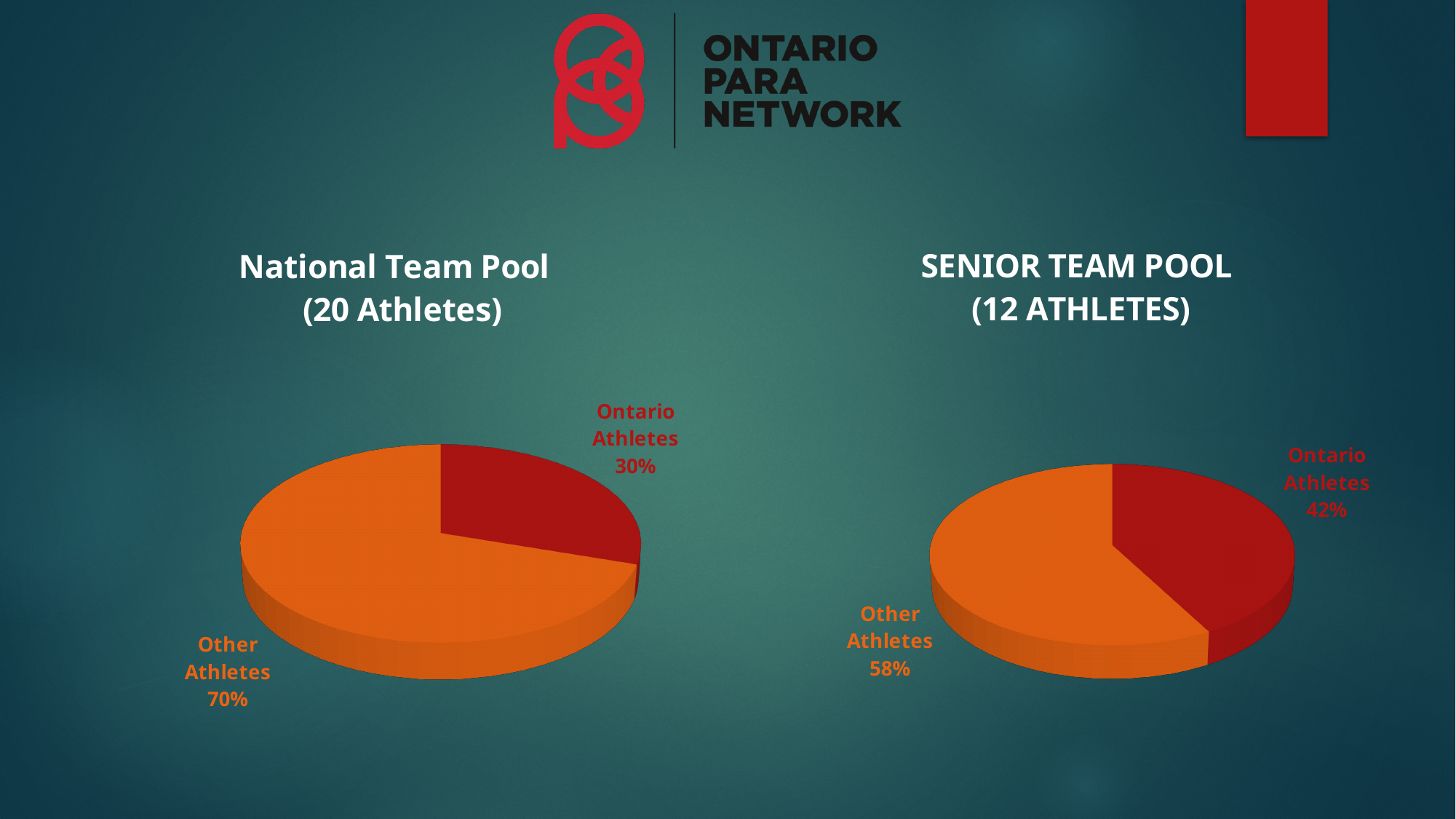
How many slices does the Senior Team Pool chart have? 2 In the National Team Pool chart, what is the difference between the Other Athletes and Ontario Athletes shares? 40% In the Senior Team Pool chart, what is the difference between the Other Athletes and Ontario Athletes shares? 16% What kind of chart is the National Team Pool chart? Pie chart In the National Team Pool chart, what share of the pie is Other Athletes? 70% In the Senior Team Pool chart, which slice is the smallest? Ontario Athletes In the Senior Team Pool chart, what share of the pie is Other Athletes? 58% In the National Team Pool chart, which slice is the largest? Other Athletes In the Senior Team Pool chart, what share of the pie is Ontario Athletes? 42% How many athletes does the Senior Team Pool chart title say are in the pool? 12 Which chart shows a larger share for Ontario Athletes, the National Team Pool chart or the Senior Team Pool chart? Senior Team Pool